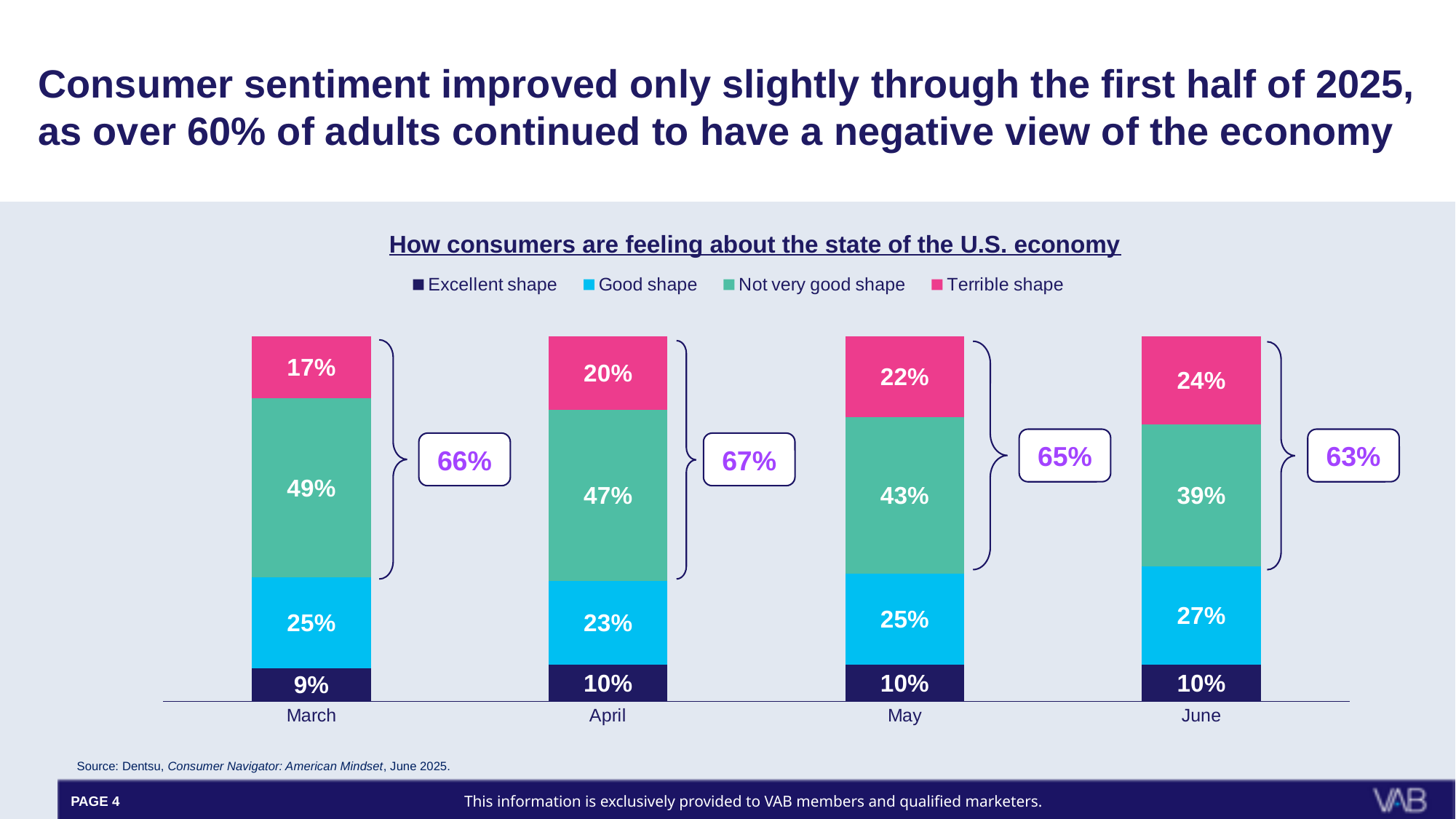
What is the difference between the "Not very good shape" values for March and June? 10% What kind of chart is shown on the slide? Stacked bar chart What is the value for "Excellent shape" in March? 9% In which month is the "Terrible shape" value highest? June In which month is the "Not very good shape" value lowest? June What is the value for "Not very good shape" in March? 49% What percentage of consumers said the economy was in "Terrible shape" in June? 24% Does the "Terrible shape" value rise or fall from March to June? Rise What is the value for "Good shape" in April? 23% How many series does the legend list? 4 How many months are shown on the x axis? 4 Which is larger, the "Good shape" value in May or in June? June